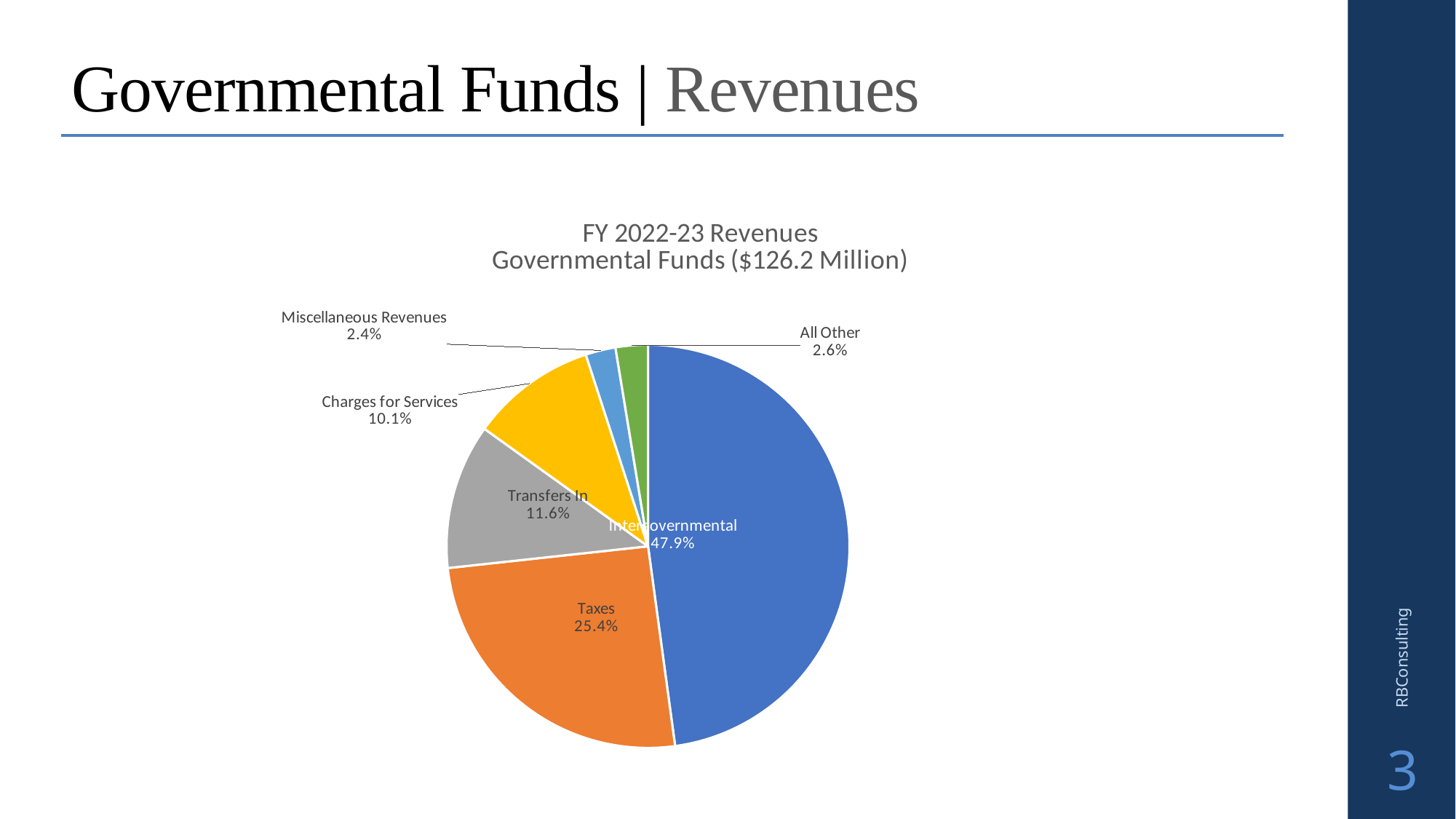
What kind of chart is shown on the slide? Pie chart What is the share for Miscellaneous Revenues? 2.4% What is the share for Transfers In? 11.6% What percentage of revenues is attributed to Taxes? 25.4% Which revenue category has the largest share of the pie? Intergovernmental How many slices does the pie chart have? 6 Which is larger, Transfers In or Charges for Services? Transfers In What total dollar amount is given in the chart title for Governmental Funds revenues? $126.2 Million What is the difference in percentage points between Intergovernmental and Taxes? 22.5 Which revenue category has the smallest share of the pie? Miscellaneous Revenues What percentage does Charges for Services represent? 10.1% What share of FY 2022-23 Governmental Funds revenues comes from Intergovernmental? 47.9%